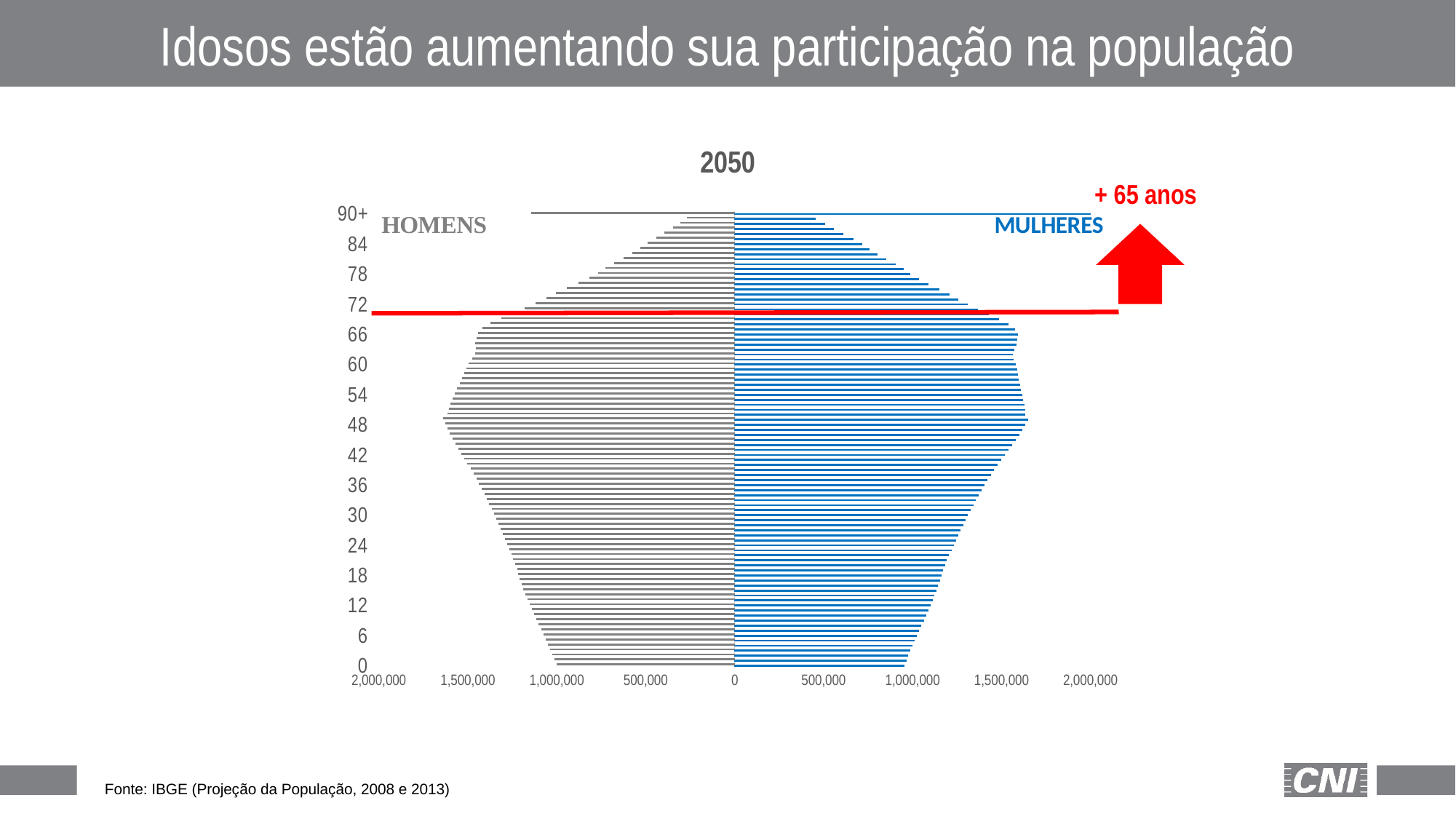
Is the value for HOMENS at age 48 greater or less than 1,500,000? greater What kind of chart is shown on the slide? Bar chart (population pyramid) Is the value for MULHERES at age 30 greater or less than 1,000,000? greater Is the value for HOMENS at age 72 greater or less than 1,000,000? greater What is the title of the chart? 2050 At age 90+, which series has the larger value, HOMENS or MULHERES? MULHERES Which series is drawn in blue? MULHERES How many series does the chart show? 2 What is the highest value shown on the horizontal axis? 2,000,000